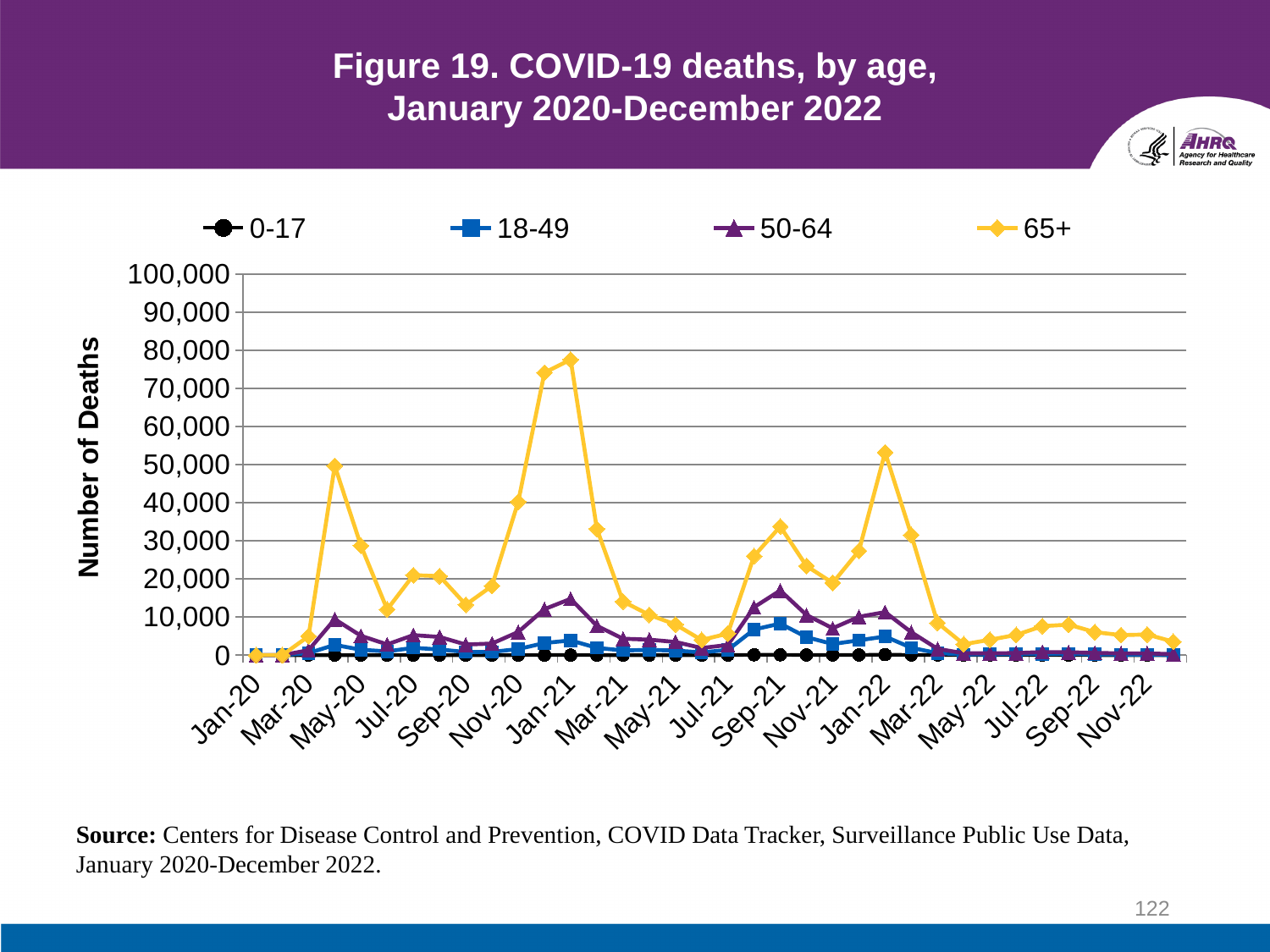
What is the label on the vertical axis? Number of Deaths Do deaths for the 65+ group rise or fall from Jan-22 to Mar-22? fall What is the title of the chart? Figure 19. COVID-19 deaths, by age, January 2020-December 2022 Is the number of deaths for the 65+ group in Jan-21 greater or less than 70,000? greater Is the number of deaths for the 50-64 group in Jan-21 greater or less than 10,000? greater What type of chart is shown on the slide? line chart Is the number of deaths for the 65+ group in Jul-21 greater or less than 10,000? less Which age group has the lowest number of deaths throughout the period? 0-17 How many series does the legend list? 4 In Jan-21, which group had more deaths, 65+ or 50-64? 65+ Which age group has the highest number of deaths at its peak? 65+